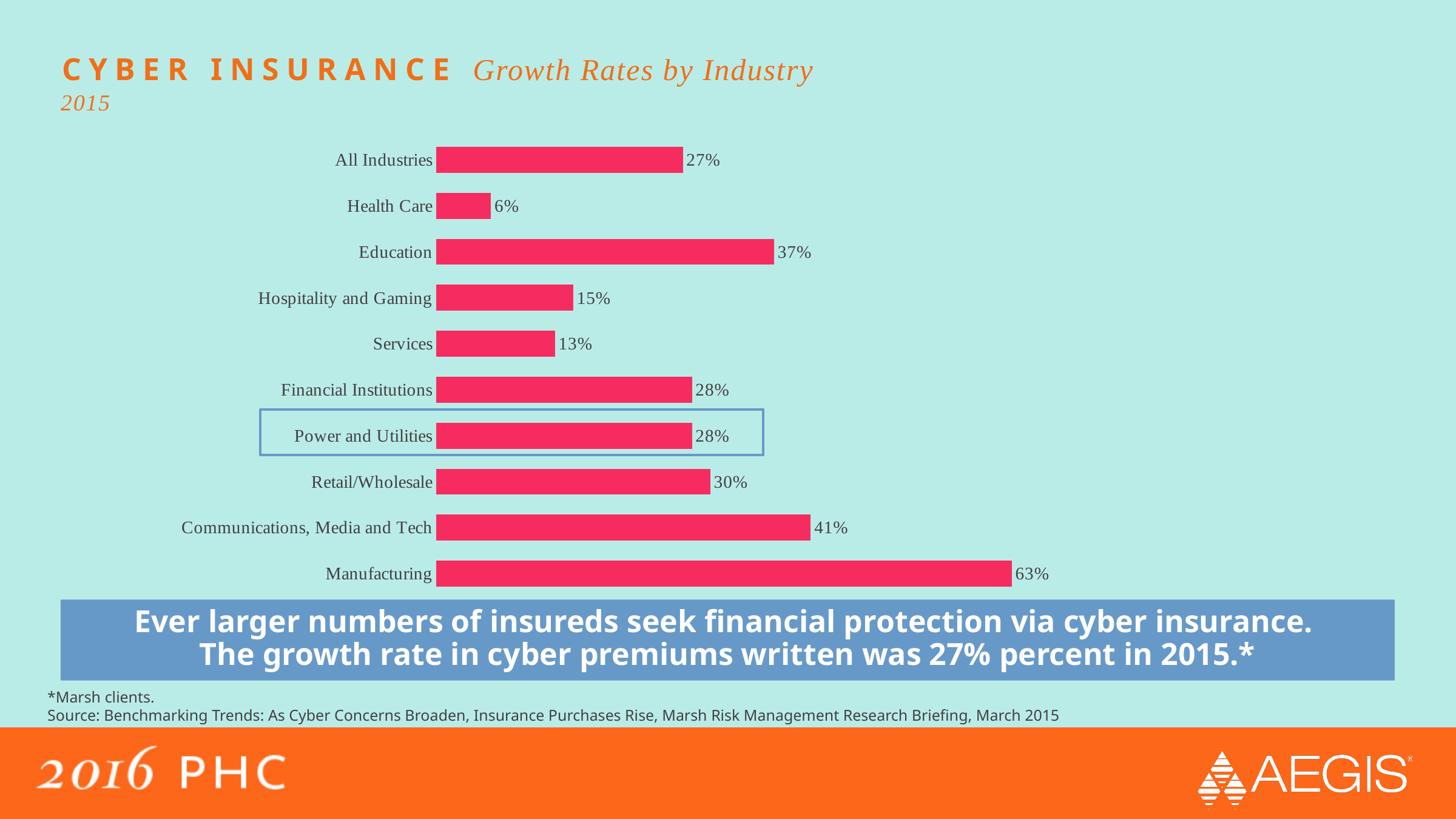
Which industry has the highest growth rate? Manufacturing How many categories are shown in the chart? 10 What is the growth rate for Power and Utilities? 28% What is the growth rate for Health Care? 6% Which industry has the lowest growth rate? Health Care What is the growth rate for Communications, Media and Tech? 41% Which has a higher growth rate, Education or Retail/Wholesale? Education What is the growth rate for Manufacturing? 63% What kind of chart is shown on the slide? Bar chart What is the difference between the growth rates for Education and Services? 24% Which category is highlighted with a box outline on the chart? Power and Utilities What is the difference between the growth rates for Manufacturing and All Industries? 36%